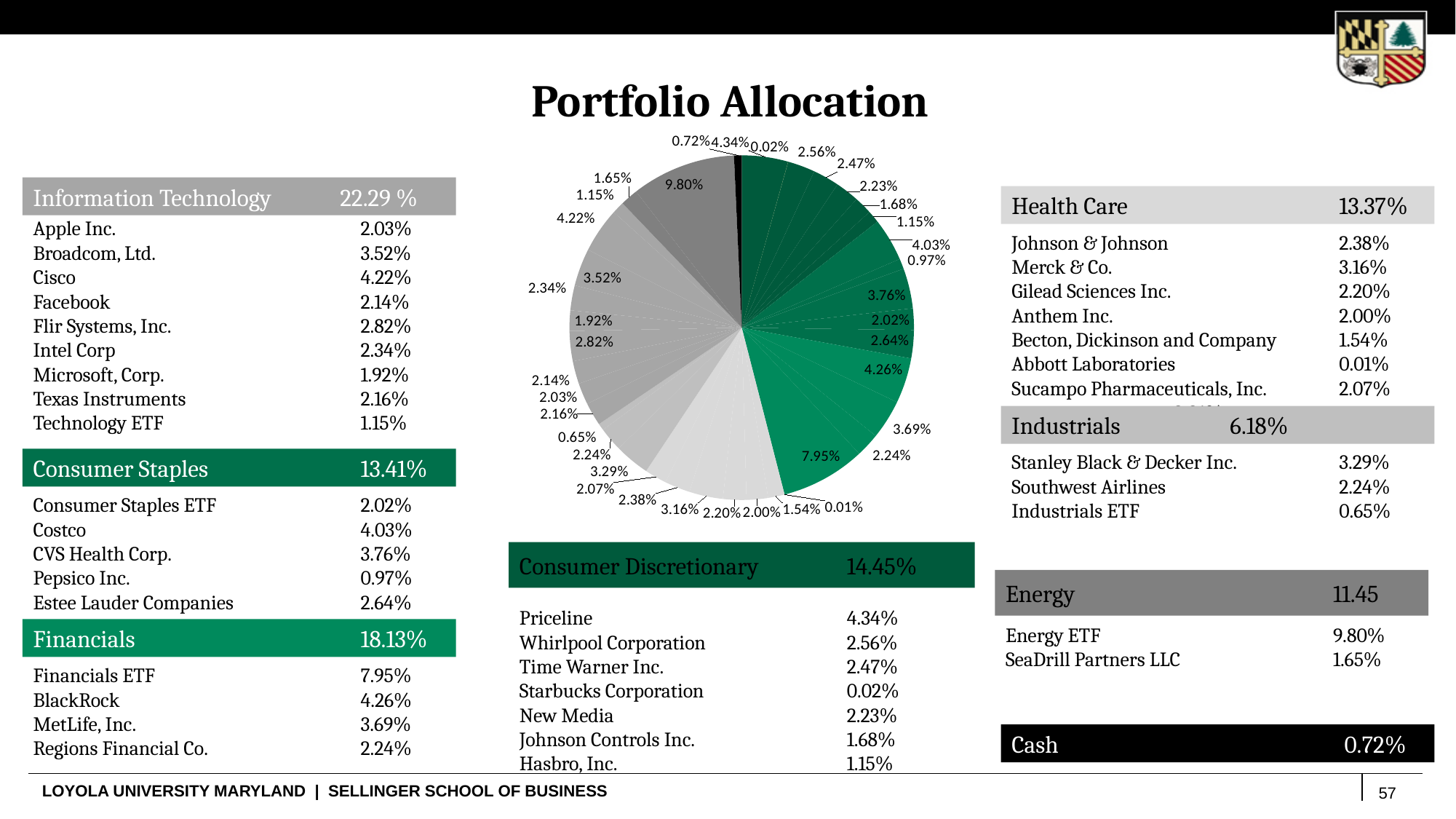
What is the largest slice value labelled on the pie chart? 9.80% Which slice is larger: Costco or CVS Health Corp.? Costco What is the portfolio share of the Financials ETF slice? 7.95% What is the difference between the Cisco slice (4.22%) and the Broadcom, Ltd. slice (3.52%)? 0.70% What is the share of the pie chart labelled for Priceline? 4.34% What is the title of the slide containing the pie chart? Portfolio Allocation What is the smallest slice value labelled on the pie chart? 0.01% What is the share of the pie chart labelled for Cash? 0.72% What kind of chart is shown on the slide? pie chart Which holding corresponds to the largest slice of the pie chart (9.80%)? Energy ETF What is the difference between the largest slice (9.80%) and the second-largest slice (7.95%)? 1.85% Which slice is larger: Financials ETF or BlackRock? Financials ETF